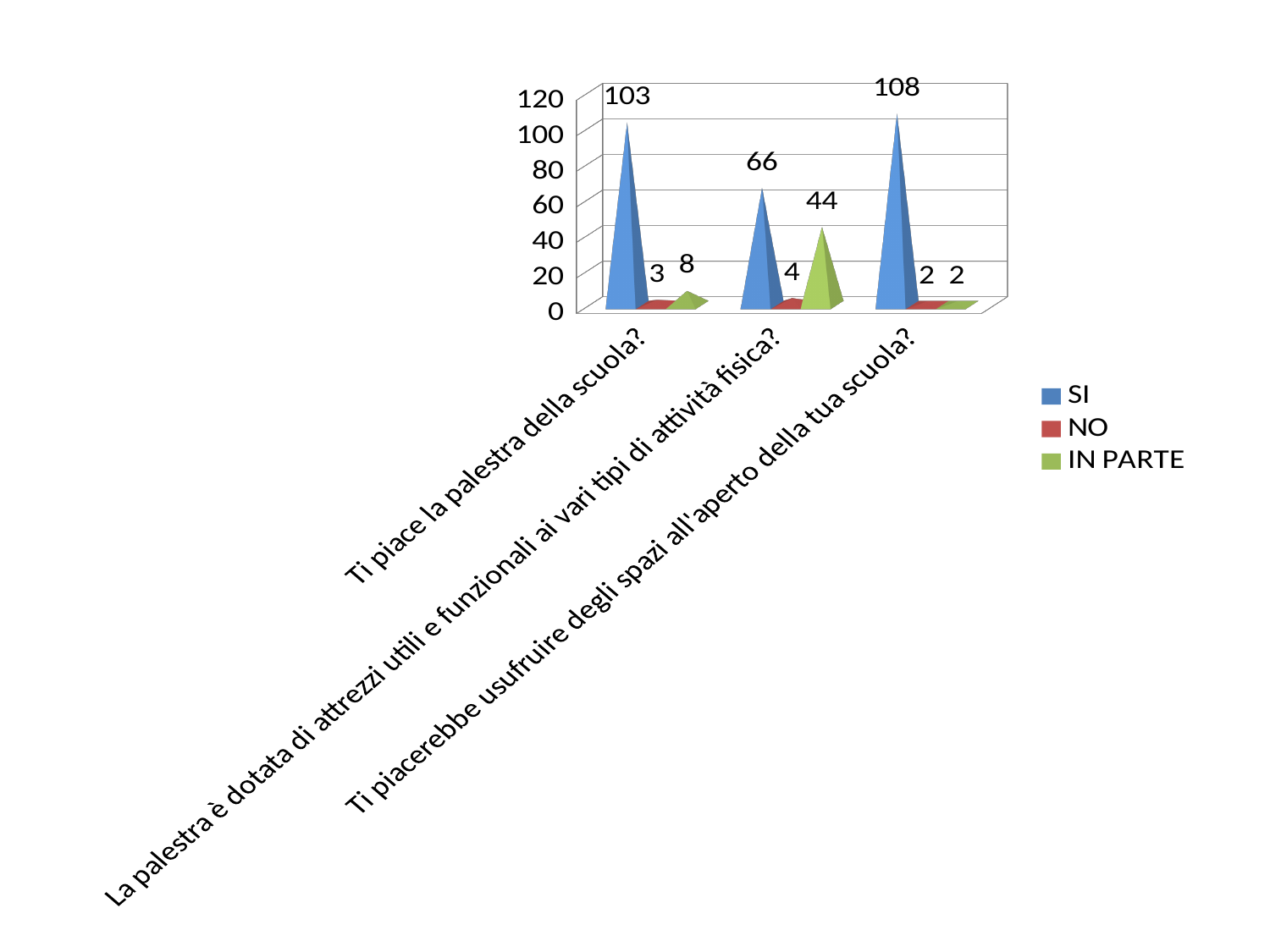
Which is larger for "La palestra è dotata di attrezzi utili e funzionali ai vari tipi di attività fisica?": the SI value or the IN PARTE value? SI Which colour represents the IN PARTE series in the legend? green What is the difference between the IN PARTE and NO values for "Ti piace la palestra della scuola?" 5 Which question has the lowest SI value? La palestra è dotata di attrezzi utili e funzionali ai vari tipi di attività fisica? What is the difference between the SI values for "Ti piacerebbe usufruire degli spazi all'aperto della tua scuola?" and "Ti piace la palestra della scuola?" 5 How many questions (categories) are shown on the x axis? 3 What is the IN PARTE value for "La palestra è dotata di attrezzi utili e funzionali ai vari tipi di attività fisica?" 44 What is the SI value for "Ti piace la palestra della scuola?" 103 What kind of chart is shown on the slide? bar chart Which question has the highest SI value? Ti piacerebbe usufruire degli spazi all'aperto della tua scuola? What is the NO value for "Ti piacerebbe usufruire degli spazi all'aperto della tua scuola?" 2 How many series does the legend list? 3